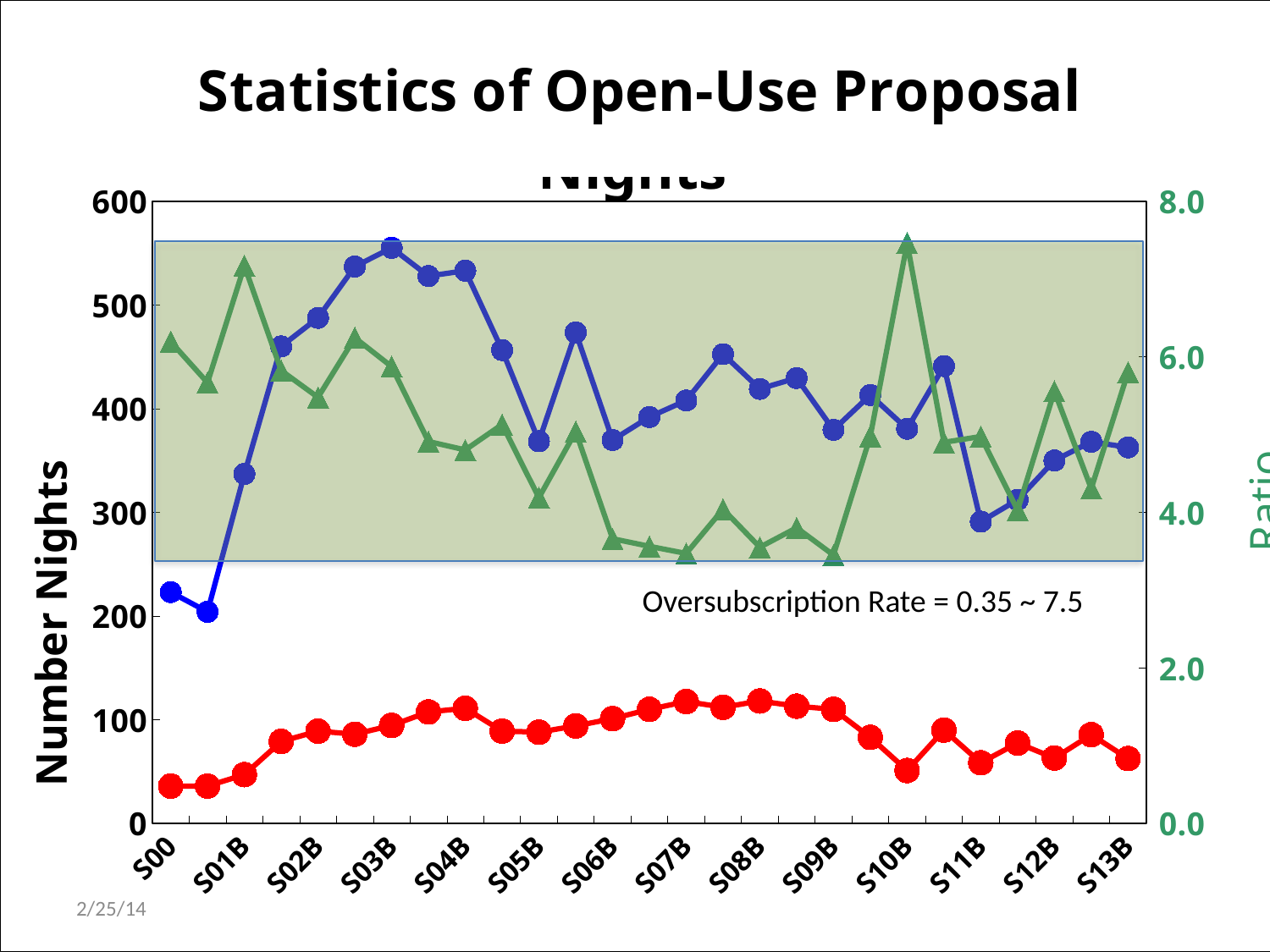
Is the value of the green line at S09B greater or less than 4.0 on the right axis? less Is the value of the blue line at S03B greater or less than 500? greater Is the value of the red line at S00 greater or less than 100? less What is the title of the left vertical axis? Number Nights At which x-axis label does the green line reach its highest value? S10B What kind of chart is shown on the slide? line chart Does the red line rise or fall from S00 to S04B? rise How many category labels are shown along the x axis? 14 What oversubscription rate range is stated in the text on the chart? 0.35 ~ 7.5 Which is larger, the blue line value at S00 or at S03B? S03B